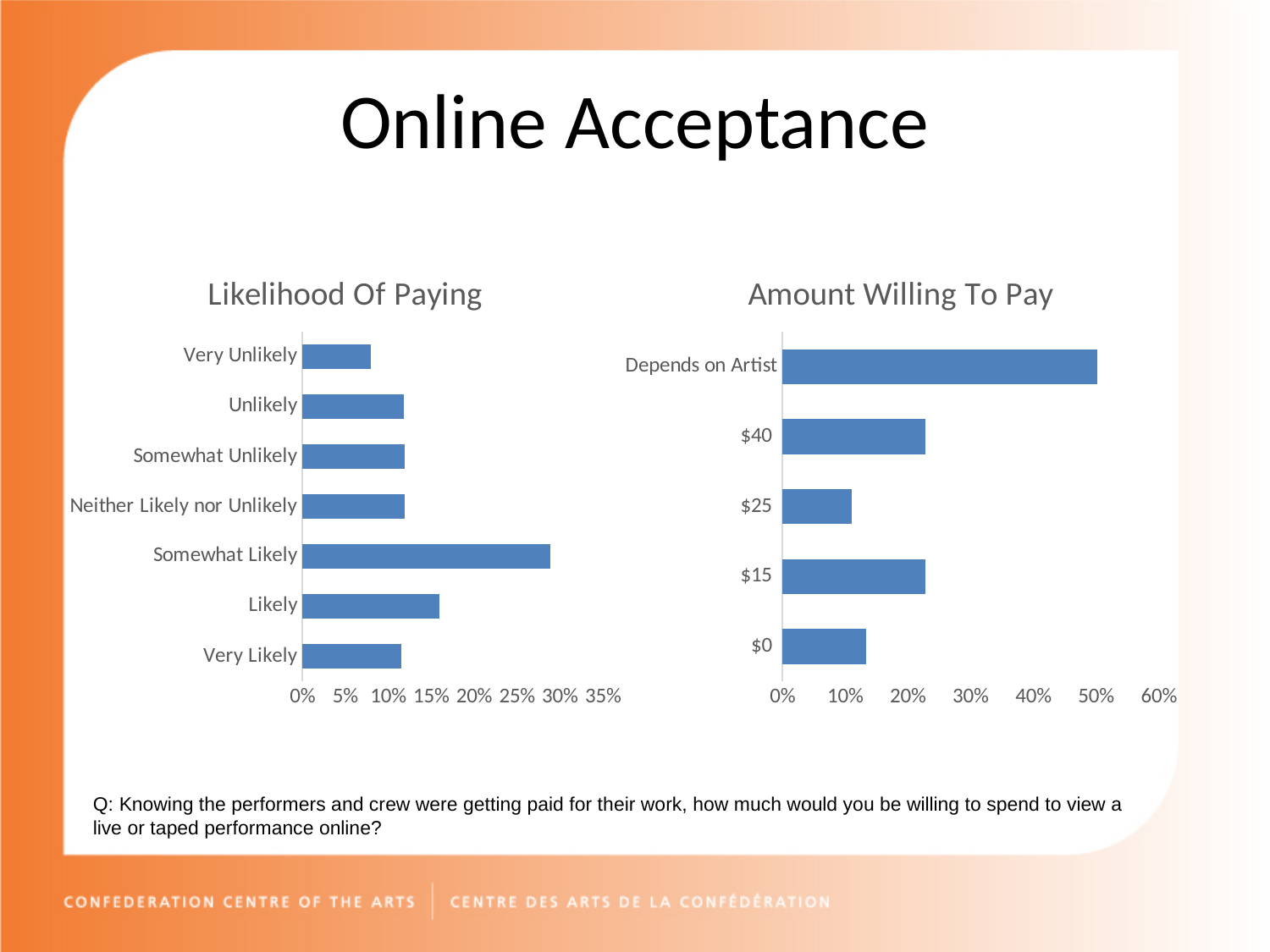
How many categories are shown in the Amount Willing To Pay chart? 5 How many categories are shown in the Likelihood Of Paying chart? 7 In the Likelihood Of Paying chart, is the value for Somewhat Likely greater or less than 25%? greater What kind of chart is the Amount Willing To Pay chart? Bar chart In the Likelihood Of Paying chart, is the value for Very Unlikely greater or less than 10%? less In the Likelihood Of Paying chart, which is larger, the value for Likely or the value for Very Likely? Likely In the Amount Willing To Pay chart, which category has the lowest value? $25 In the Amount Willing To Pay chart, is the value for $25 greater or less than 20%? less In the Likelihood Of Paying chart, which category has the highest value? Somewhat Likely In the Likelihood Of Paying chart, which category has the lowest value? Very Unlikely In the Amount Willing To Pay chart, which category has the highest value? Depends on Artist